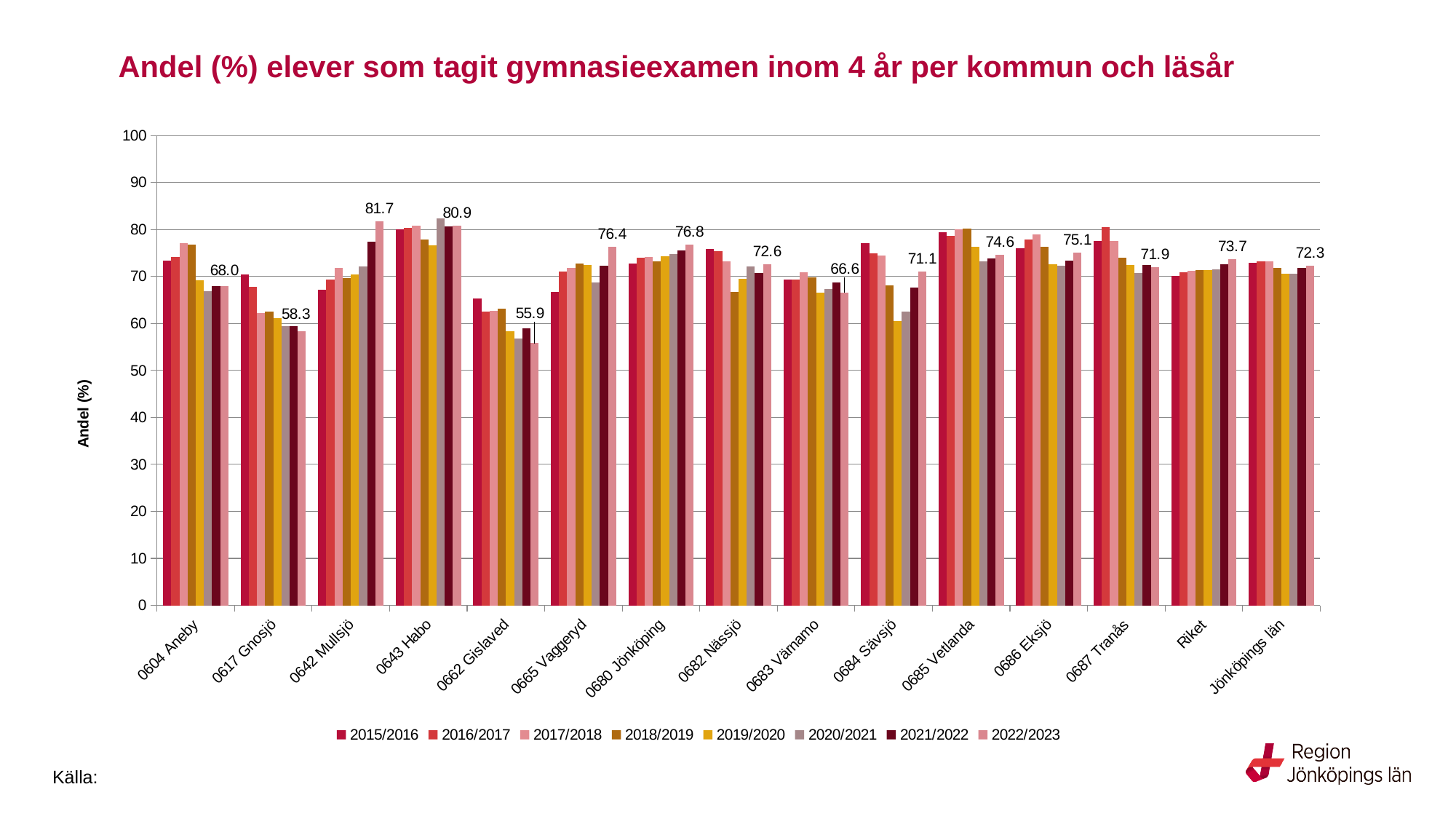
Is the 2022/2023 value for 0617 Gnosjö greater or less than 60? less Which municipality has the lowest 2022/2023 value? 0662 Gislaved What is the 2022/2023 value for Riket? 73.7 What is the difference between the 2022/2023 values for 0642 Mullsjö and 0662 Gislaved? 25.8 What kind of chart is shown on the slide? Bar chart What is the 2022/2023 value for Jönköpings län? 72.3 What is the 2022/2023 value for 0662 Gislaved? 55.9 How many series does the legend list? 8 What is the 2022/2023 value for 0604 Aneby? 68.0 How many categories are shown on the x axis? 15 Which municipality has the highest 2022/2023 value? 0642 Mullsjö Which has the larger 2022/2023 value, 0680 Jönköping or 0682 Nässjö? 0680 Jönköping